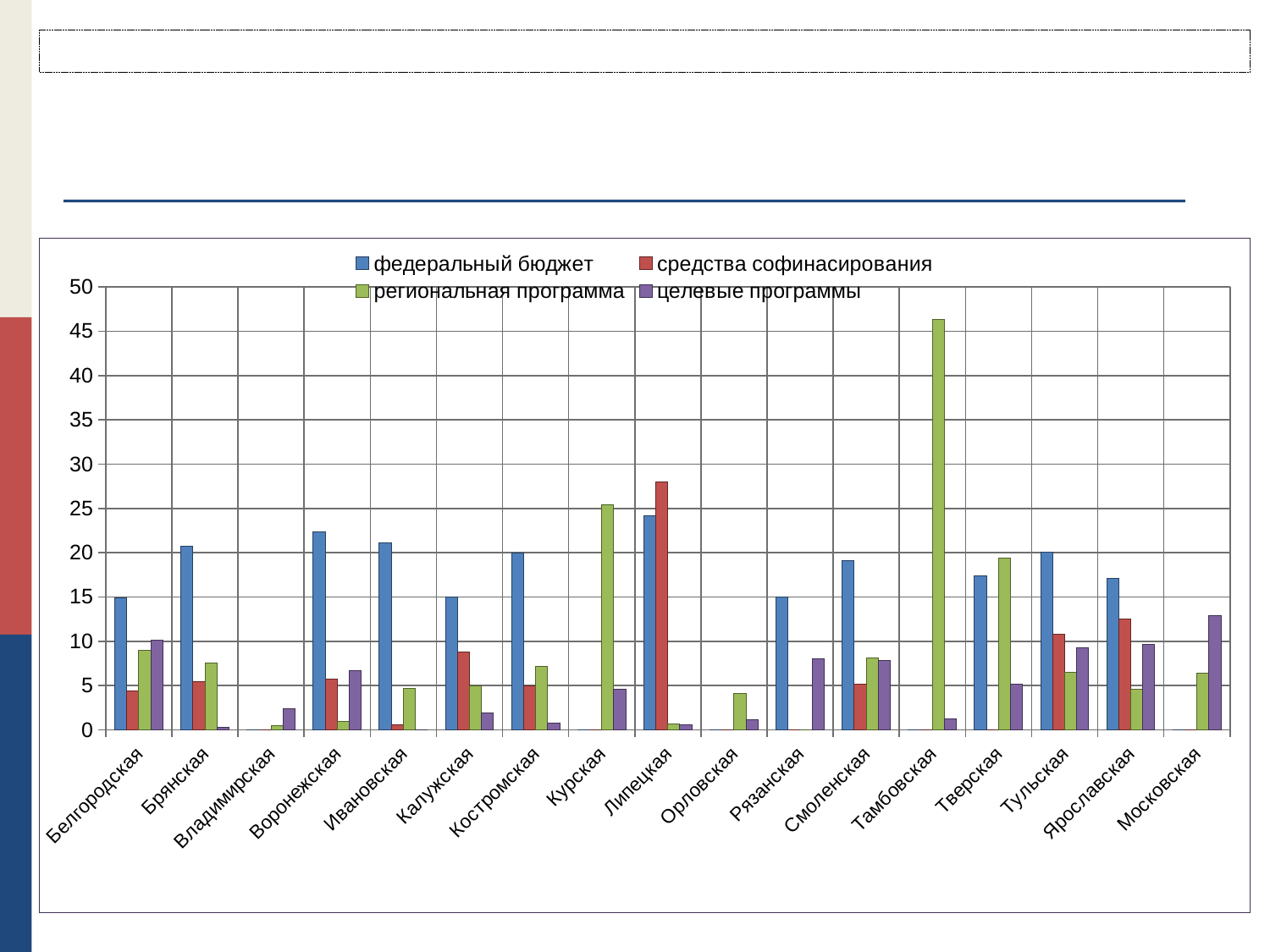
Which region has the highest value for средства софинасирования? Липецкая Which region has the highest value for региональная программа? Тамбовская How many series does the legend list? 4 Is the value for средства софинасирования in Липецкая greater or less than 25? greater In Липецкая, which is larger: федеральный бюджет or средства софинасирования? средства софинасирования How many regions (categories) are shown on the x axis? 17 Is the value for целевые программы in Московская greater or less than 10? greater Is the value for региональная программа in Тамбовская greater or less than 40? greater Which region has the highest value for целевые программы? Московская What kind of chart is shown on the slide? bar chart Which colour represents региональная программа in the legend? green